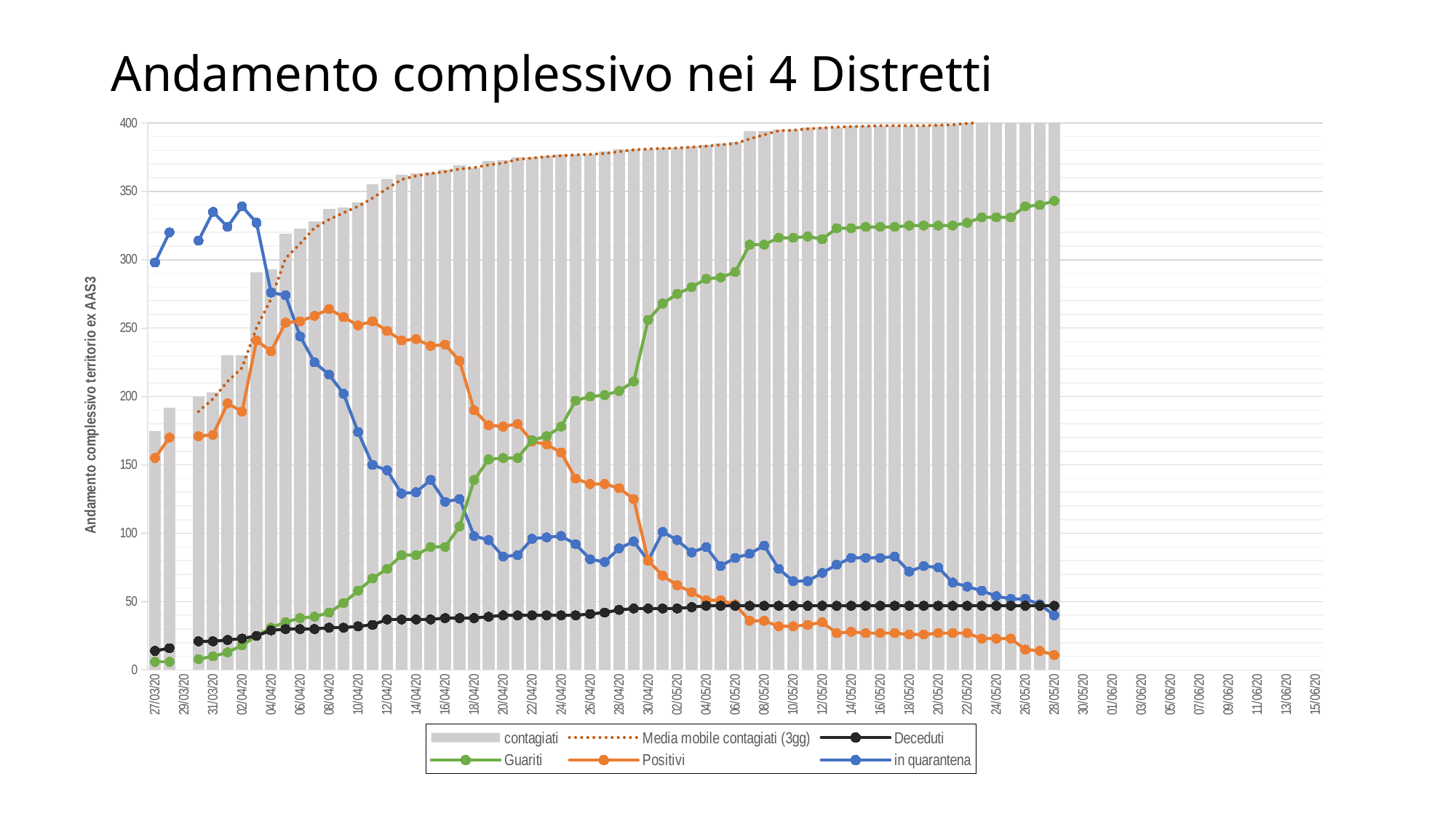
How many series does the legend list? 6 Does the Positivi series rise or fall from 08/04/20 to 28/05/20? Falls Does the Guariti series rise or fall over time along the x axis? Rises What is the title of the chart? Andamento complessivo nei 4 Distretti Is the value of in quarantena on 02/04/20 greater or less than 300? greater On 27/03/20, which is larger: in quarantena or Positivi? in quarantena Which colour is used for the Guariti series? Green Is the value of Guariti on 28/05/20 greater or less than 300? greater Is the contagiati bar on 27/03/20 greater or less than 200? less On 28/05/20, which is larger: Guariti or Positivi? Guariti What kind of chart is this? Combined bar and line chart